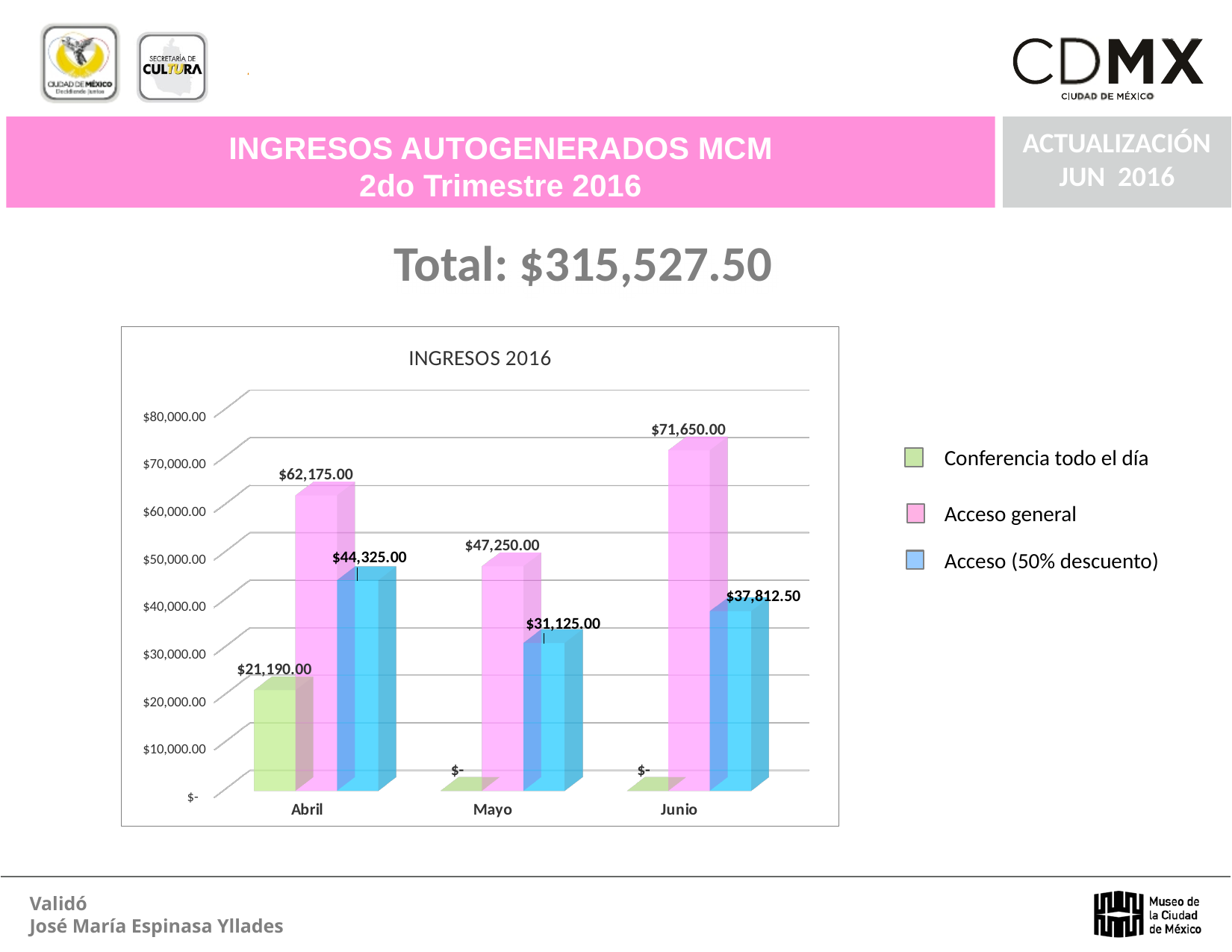
What is the value for Conferencia todo el día in Abril? $21,190.00 What kind of chart is shown? Bar chart In which month is Acceso general highest? Junio What is the value for Acceso general in Junio? $71,650.00 What is the value for Acceso (50% descuento) in Mayo? $31,125.00 What is the title of the chart? INGRESOS 2016 Which is larger: Acceso (50% descuento) in Abril or Acceso (50% descuento) in Junio? Acceso (50% descuento) in Abril What is the value for Acceso general in Abril? $62,175.00 What is the difference between Acceso general in Junio and Acceso general in Abril? $9,475.00 How many series does the legend list? 3 How many months are shown on the x axis? 3 In which month is Acceso (50% descuento) lowest? Mayo